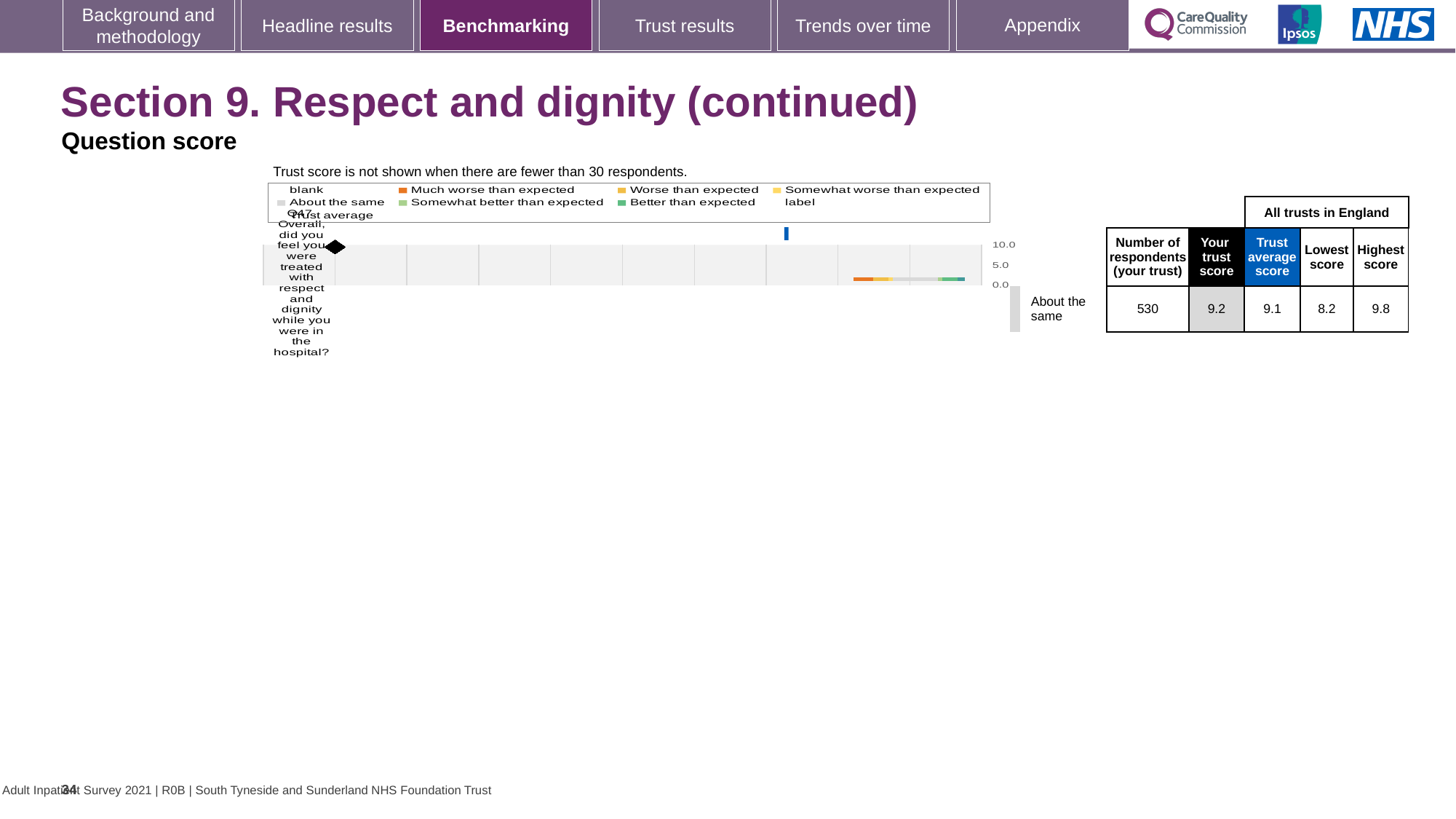
What is the trust's score for Q47 (Your trust score)? 9.2 How many respondents from the trust answered Q47? 530 Is the trust's score for Q47 greater or less than 5.0? greater What is the highest score among all trusts in England for Q47? 9.8 What kind of chart is shown on the slide? bar chart Which benchmarking category is the trust's Q47 result placed in? About the same What is the lowest score among all trusts in England for Q47? 8.2 Which is larger for Q47: the trust's own score or the trust average score? the trust's own score How many survey questions are plotted in the chart? 1 What is the highest value shown on the chart's score axis? 10.0 What is the difference between the highest score and the lowest score for Q47? 1.6 What is the trust average score for all trusts in England for Q47? 9.1